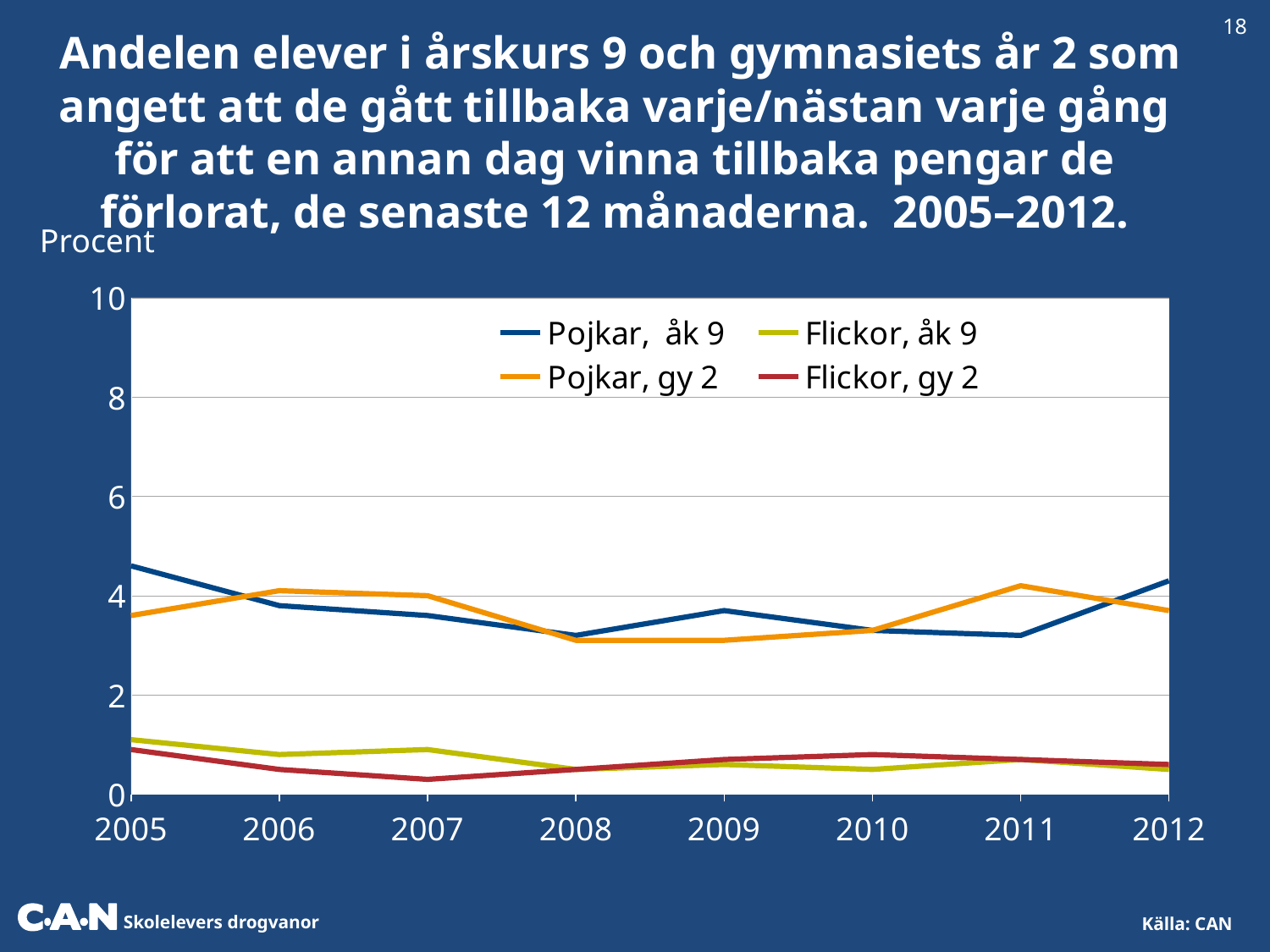
In which year does the Pojkar, åk 9 series reach its highest value? 2005 Is the value for Flickor, åk 9 in 2007 greater or less than 2? less Is the value for Pojkar, gy 2 in 2008 greater or less than 4? less Is the value for Pojkar, åk 9 in 2005 greater or less than 4? greater Which is larger in 2012: Pojkar, åk 9 or Pojkar, gy 2? Pojkar, åk 9 What kind of chart is shown on the slide? Line chart What label is shown on the vertical axis of the chart? Procent Which is larger in 2006: Pojkar, åk 9 or Pojkar, gy 2? Pojkar, gy 2 How many series does the legend list? 4 How many years are shown along the x axis? 8 Does the Pojkar, åk 9 series rise or fall from 2005 to 2008? Fall Which series has the highest value in 2005? Pojkar, åk 9